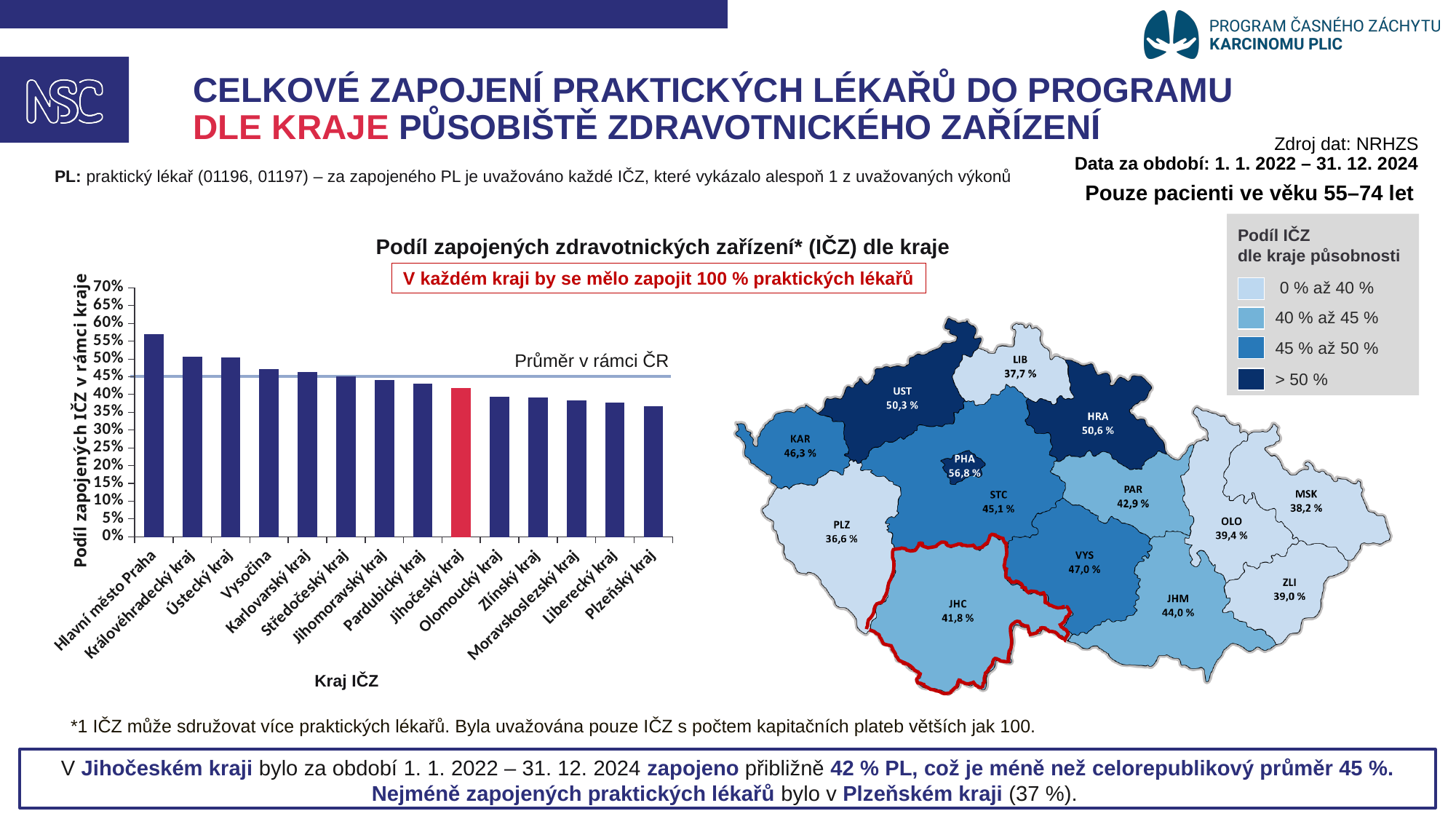
In the bar chart, which region's bar is highlighted in red? Jihočeský kraj Do the bar values rise or fall from left to right along the x axis of the bar chart? fall In the bar chart, is the value for Hlavní město Praha greater or less than 50%? greater What does the horizontal line across the bar chart represent, according to its label? Průměr v rámci ČR In the bar chart, which is larger: the value for Karlovarský kraj or for Olomoucký kraj? Karlovarský kraj In the bar chart, is the value for Plzeňský kraj greater or less than 40%? less On the map, what share is printed for PHA (Praha)? 56,8 % In the bar chart, is the value for Jihočeský kraj greater or less than 45%? less In the bar chart, which region has the lowest share of involved IČZ? Plzeňský kraj How many regions (categories) are shown in the bar chart? 14 What kind of chart is 'Podíl zapojených zdravotnických zařízení* (IČZ) dle kraje'? bar chart In the bar chart, which region has the highest share of involved IČZ? Hlavní město Praha